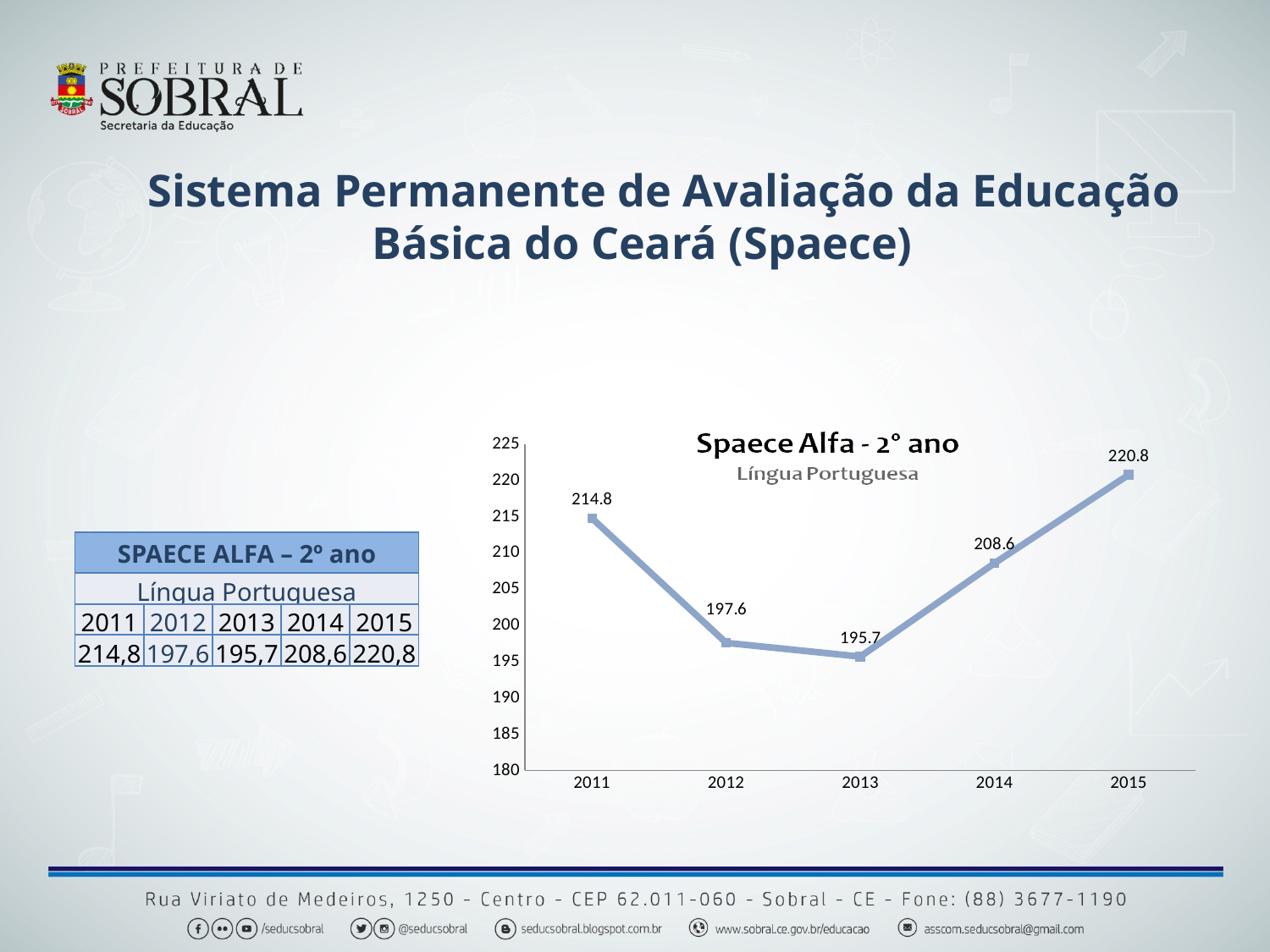
How many years are plotted in the chart? 5 What is the value for 2011 in the chart? 214.8 What is the value for 2013 in the chart? 195.7 What kind of chart is shown on the slide? line chart What is the difference between the values for 2014 and 2013? 12.9 Which is larger, the value for 2012 or the value for 2014? 2014 Which year has the highest value in the chart? 2015 Which year has the lowest value in the chart? 2013 What is the title of the chart? Spaece Alfa - 2° ano What is the difference between the values for 2015 and 2011? 6 Is the value for 2012 greater or less than 200? less What is the value for 2015 in the chart? 220.8